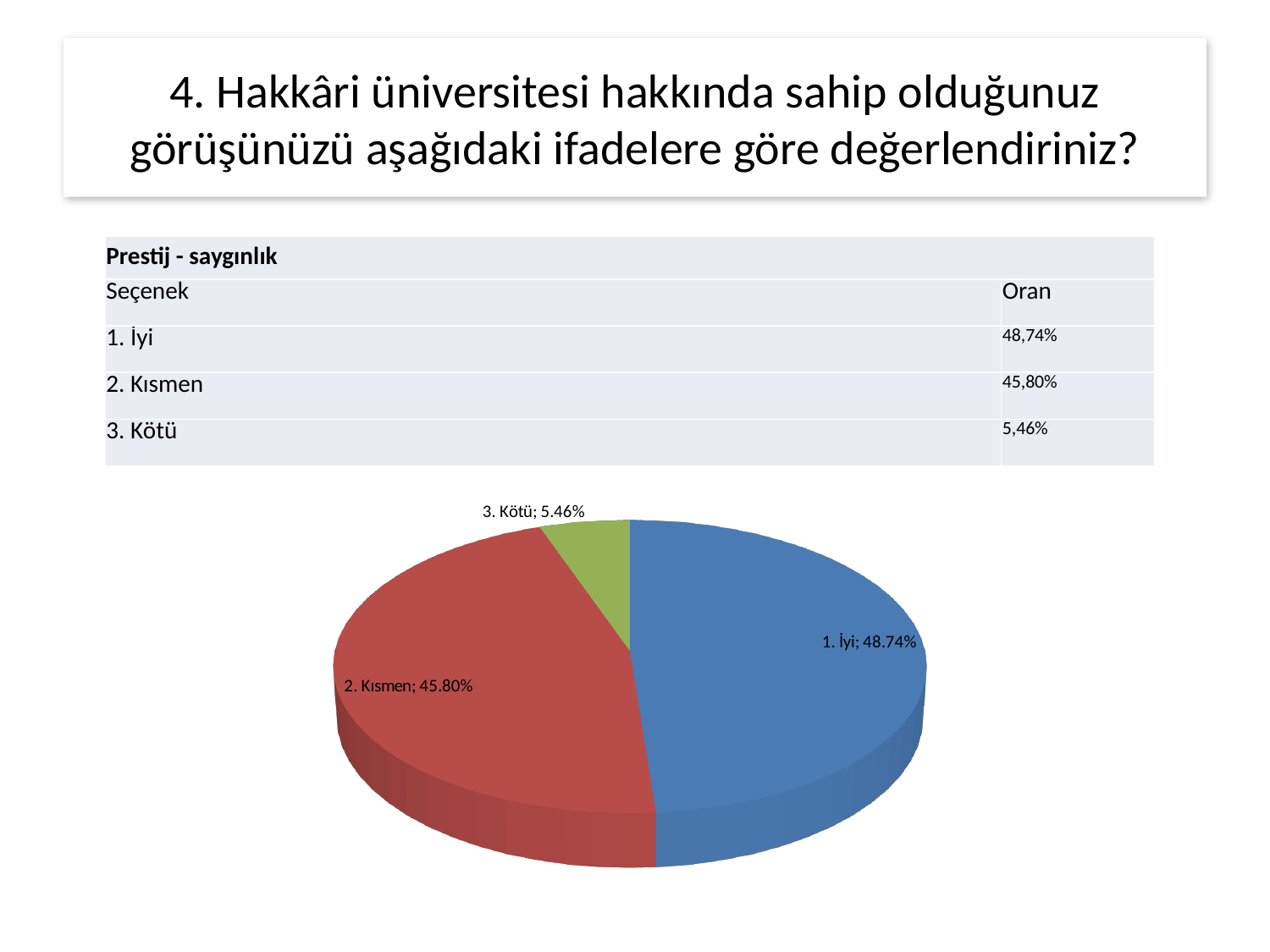
What colour is the slice for "2. Kısmen" in the pie chart? red What is the value shown for the slice "1. İyi"? 48.74% What kind of chart is shown on the slide? pie chart How many slices does the pie chart have? 3 Which is larger, the slice for "2. Kısmen" or the slice for "3. Kötü"? 2. Kısmen Which slice of the pie chart is the smallest? 3. Kötü What is the difference between the values for "1. İyi" and "2. Kısmen"? 2.94% Which slice of the pie chart is the largest? 1. İyi What is the value shown for the slice "3. Kötü"? 5.46% What is the value shown for the slice "2. Kısmen"? 45.80% What is the difference between the values for "2. Kısmen" and "3. Kötü"? 40.34% What share of the pie does the "3. Kötü" slice represent? 5.46%